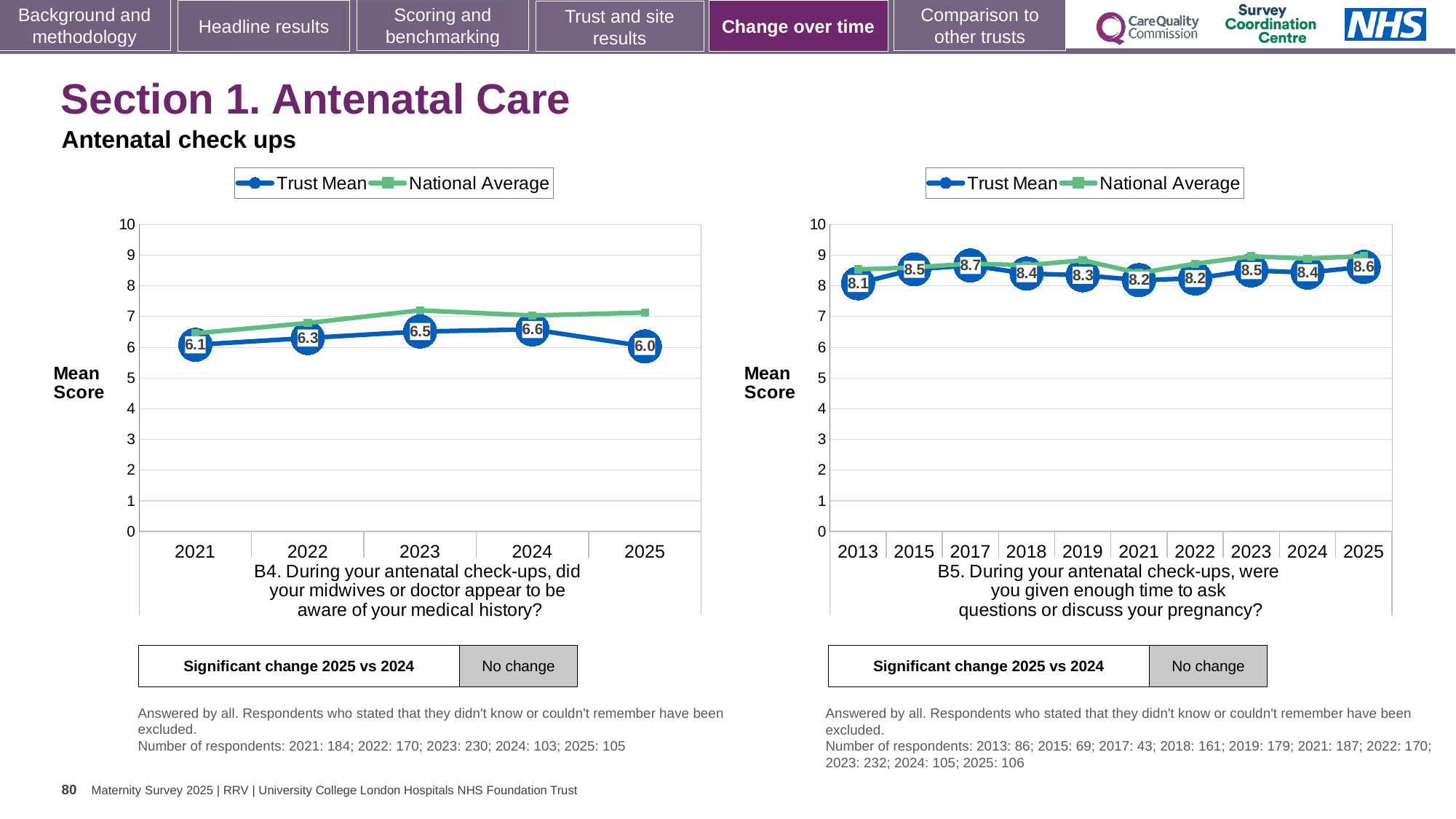
In the left chart (B4), what is the Trust Mean for 2023? 6.5 In the right chart (B5), which year has the lowest Trust Mean? 2013 In the left chart (B4), which year has the lowest Trust Mean? 2025 What type of chart is the left chart (B4)? Line chart In the left chart (B4), how many years are plotted on the x axis? 5 In the left chart (B4), what is the difference between the Trust Mean for 2024 and 2025? 0.6 How many series does the legend of the right chart (B5) list? 2 In the right chart (B5), is the Trust Mean for 2025 larger or smaller than the Trust Mean for 2013? larger In the left chart (B4), which year has the highest Trust Mean? 2024 In the left chart (B4), is the National Average for 2023 greater or less than 7? greater In the right chart (B5), what is the Trust Mean for 2017? 8.7 In the right chart (B5), how many years are plotted on the x axis? 10